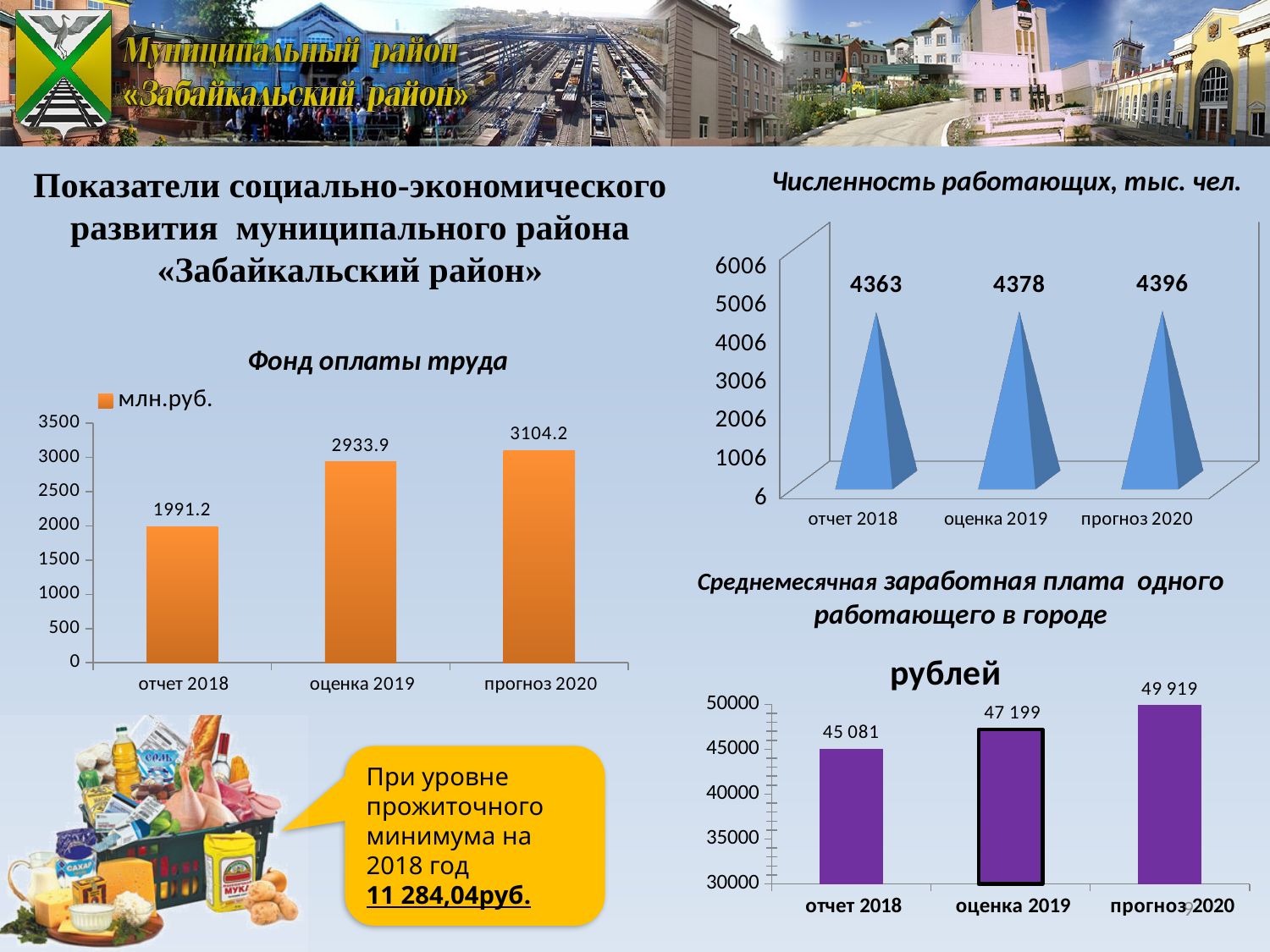
In the chart titled «Фонд оплаты труда», what unit does the legend show? млн.руб. In the chart titled «Численность работающих, тыс. чел.», do the values rise or fall from «отчет 2018» to «прогноз 2020»? rise In the chart titled «Фонд оплаты труда», what is the difference between «прогноз 2020» and «отчет 2018»? 1113.0 In the chart titled «Среднемесячная заработная плата одного работающего в городе», what is the value for «отчет 2018»? 45 081 In the chart titled «Численность работающих, тыс. чел.», what is the difference between «оценка 2019» and «отчет 2018»? 15 In the chart titled «Фонд оплаты труда», which category has the lowest value? отчет 2018 What kind of chart is the one titled «Среднемесячная заработная плата одного работающего в городе»? bar chart In the chart titled «Фонд оплаты труда», what is the value for «оценка 2019»? 2933.9 In the chart titled «Среднемесячная заработная плата одного работающего в городе», which is larger: «оценка 2019» or «отчет 2018»? оценка 2019 In the chart titled «Среднемесячная заработная плата одного работающего в городе», which category has the highest value? прогноз 2020 In the chart titled «Численность работающих, тыс. чел.», how many categories are shown? 3 In the chart titled «Численность работающих, тыс. чел.», what is the value for «прогноз 2020»? 4396